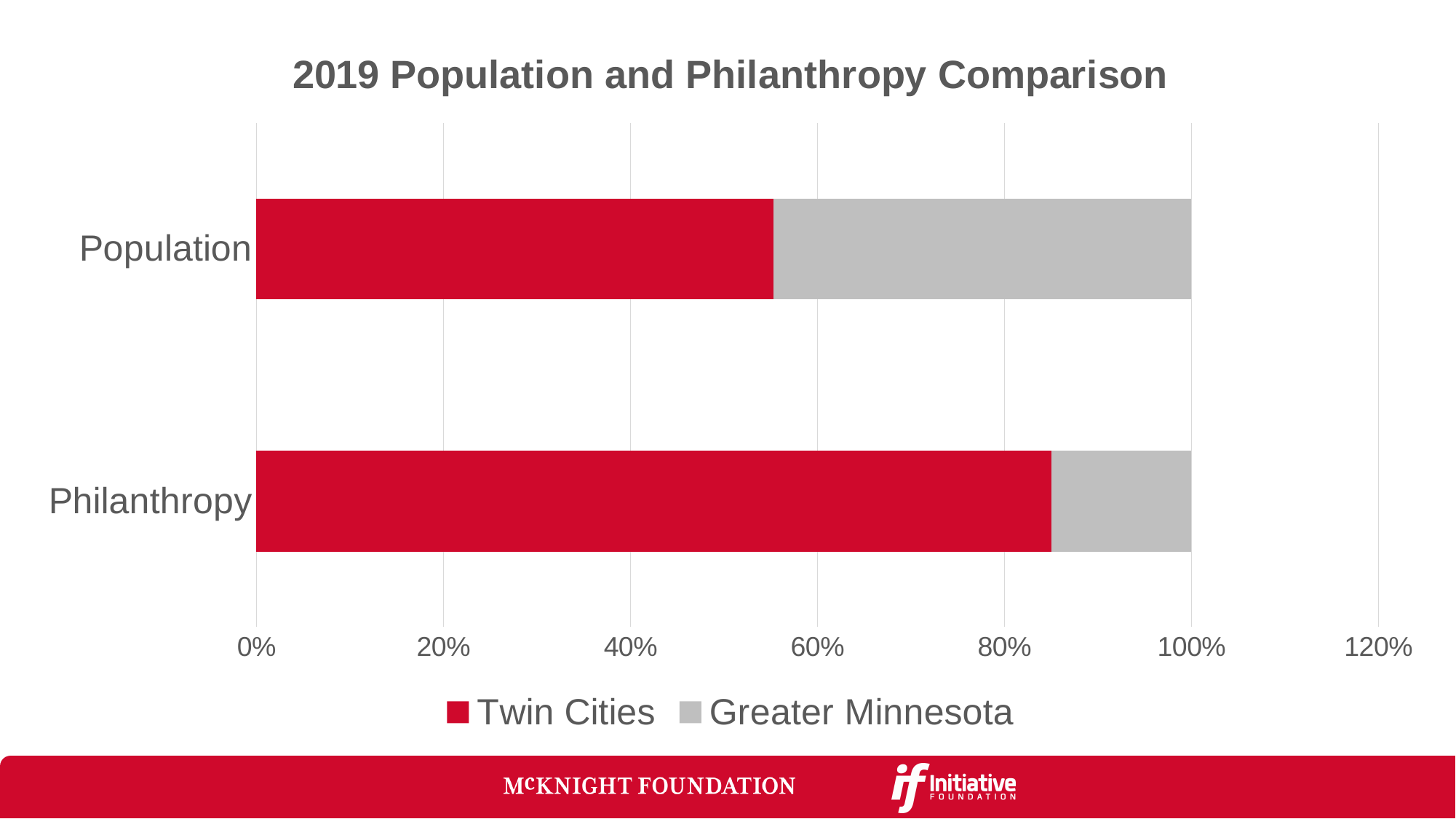
What kind of chart is shown on the slide? Stacked bar chart Is the Twin Cities value for Population greater or less than 40%? greater In the Population bar, which series has the larger share, Twin Cities or Greater Minnesota? Twin Cities Which series is shown in red? Twin Cities Is the Twin Cities value for Population greater or less than 60%? less How many categories are shown on the vertical axis? 2 Which category has the larger Greater Minnesota share, Population or Philanthropy? Population Is the Twin Cities value for Philanthropy greater or less than 80%? greater How many series does the legend list? 2 What is the total of the stacked bar for Philanthropy? 100% What is the title of the chart? 2019 Population and Philanthropy Comparison Which category has the larger Twin Cities share, Population or Philanthropy? Philanthropy